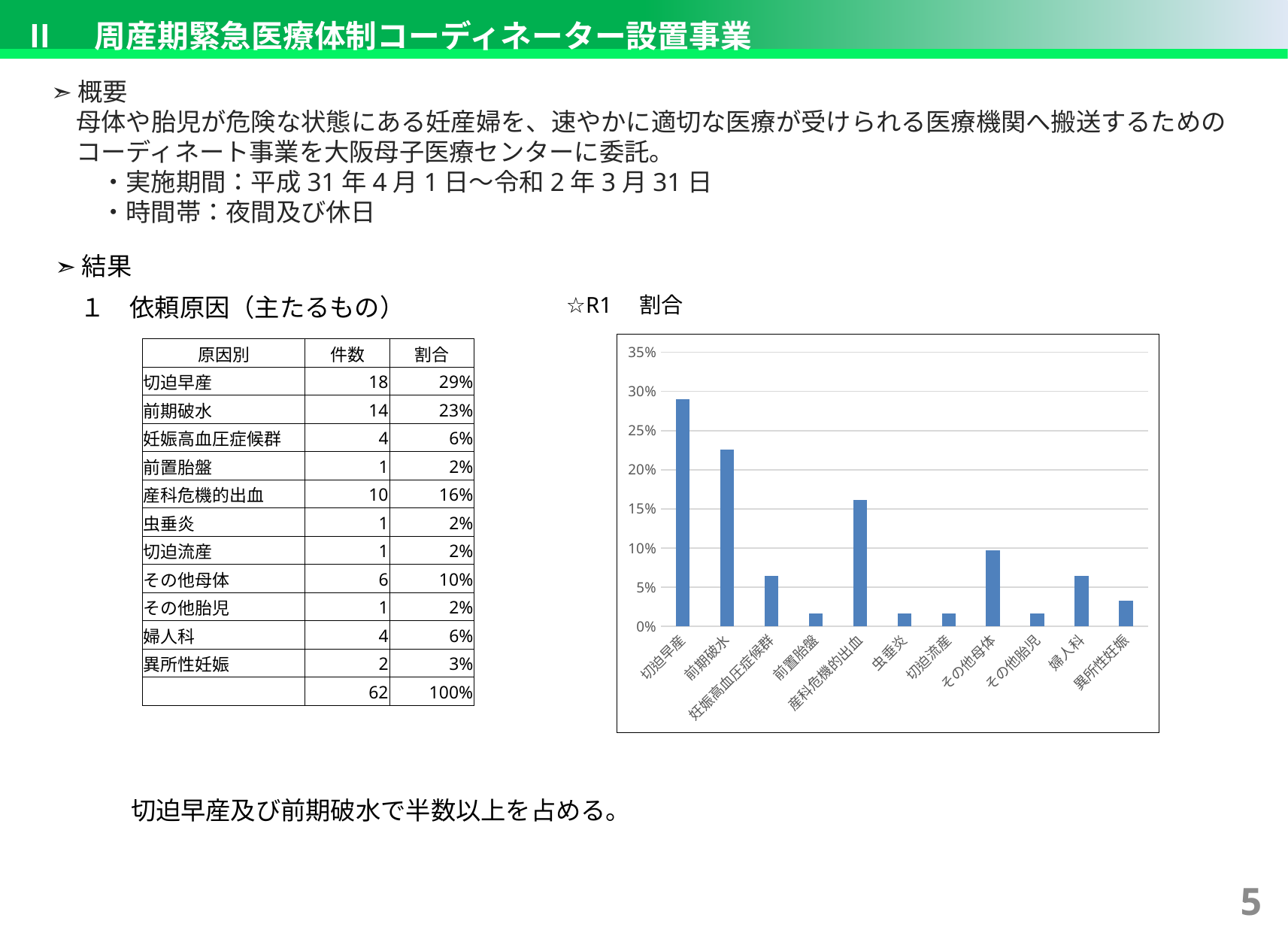
Which is larger in the chart, the value for 産科危機的出血 or the value for その他母体? 産科危機的出血 Which category has the highest bar in the chart? 切迫早産 Is the value for 産科危機的出血 greater or less than 15%? greater Which is larger in the chart, the value for 切迫早産 or the value for 前期破水? 切迫早産 What kind of chart is shown on the slide? bar chart What is the highest tick value shown on the chart's y axis? 35% Is the value for 異所性妊娠 greater or less than 5%? less How many categories are plotted on the x axis of the chart? 11 Is the value for 切迫早産 greater or less than 25%? greater What is the title written above the chart? R1 割合